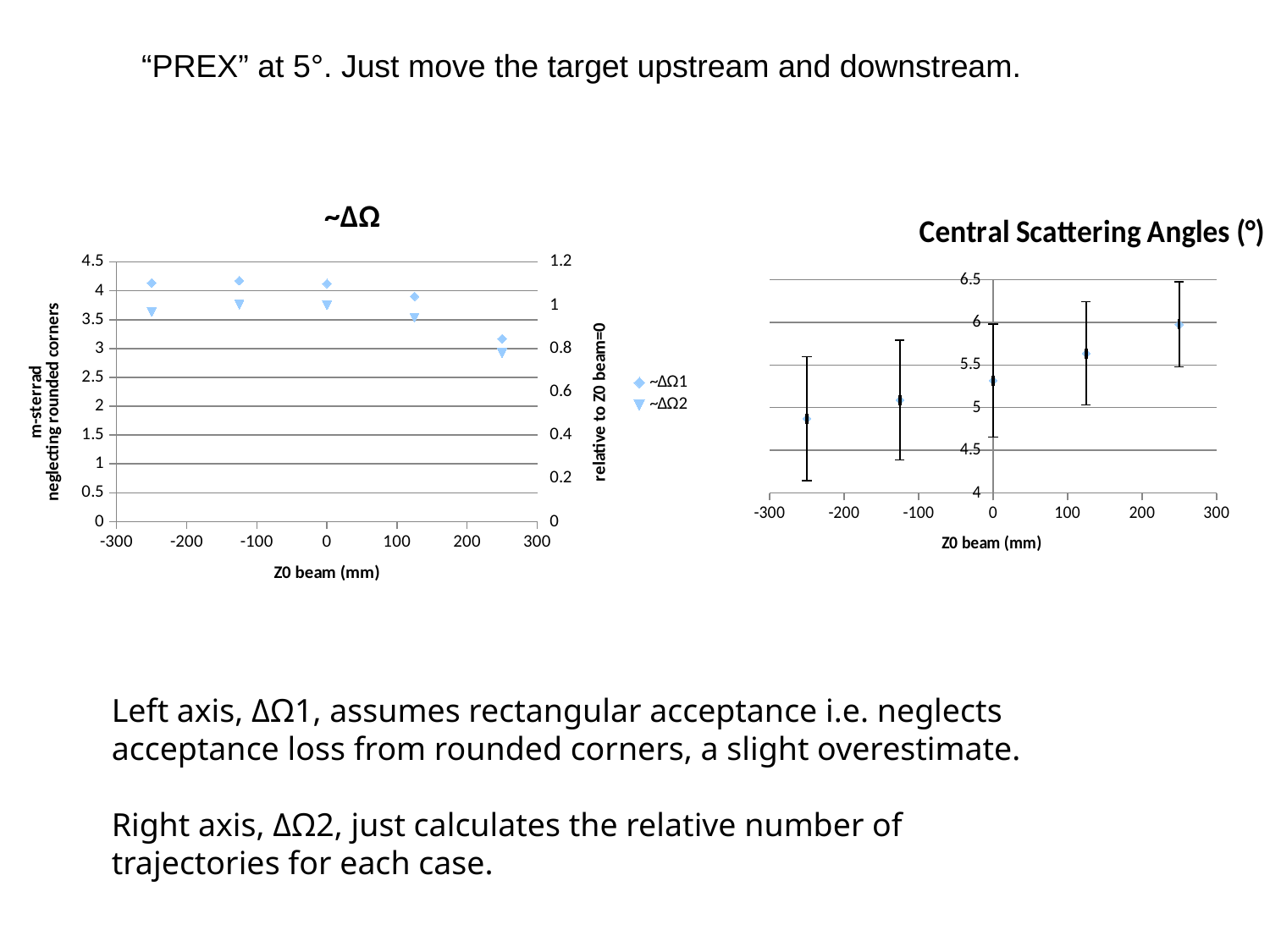
How many data points does the ~ΔΩ1 series have in the "~ΔΩ" chart? 5 How many series does the legend of the "~ΔΩ" chart list? 2 What kind of chart is the "~ΔΩ" chart on the left? scatter chart In the "~ΔΩ" chart, is the ~ΔΩ1 value at Z0 beam = 250 greater or less than 3.5 on the left axis? less In the "~ΔΩ" chart, at which Z0 beam value is the ~ΔΩ1 series lowest? 250 In the "Central Scattering Angles (°)" chart, is the value at Z0 beam = 0 greater or less than 5? greater How many data points are plotted in the "Central Scattering Angles (°)" chart? 5 In the "Central Scattering Angles (°)" chart, do the values rise or fall as Z0 beam increases from -250 to 250? rise What is the title of the chart on the right? Central Scattering Angles (°) In the "~ΔΩ" chart, is the ~ΔΩ1 value at Z0 beam = -250 greater or less than 4 on the left axis? greater In the "~ΔΩ" chart, is the ~ΔΩ1 value at Z0 beam = 0 larger or smaller than at Z0 beam = 250? larger What are the two series named in the legend of the "~ΔΩ" chart? ~ΔΩ1 and ~ΔΩ2